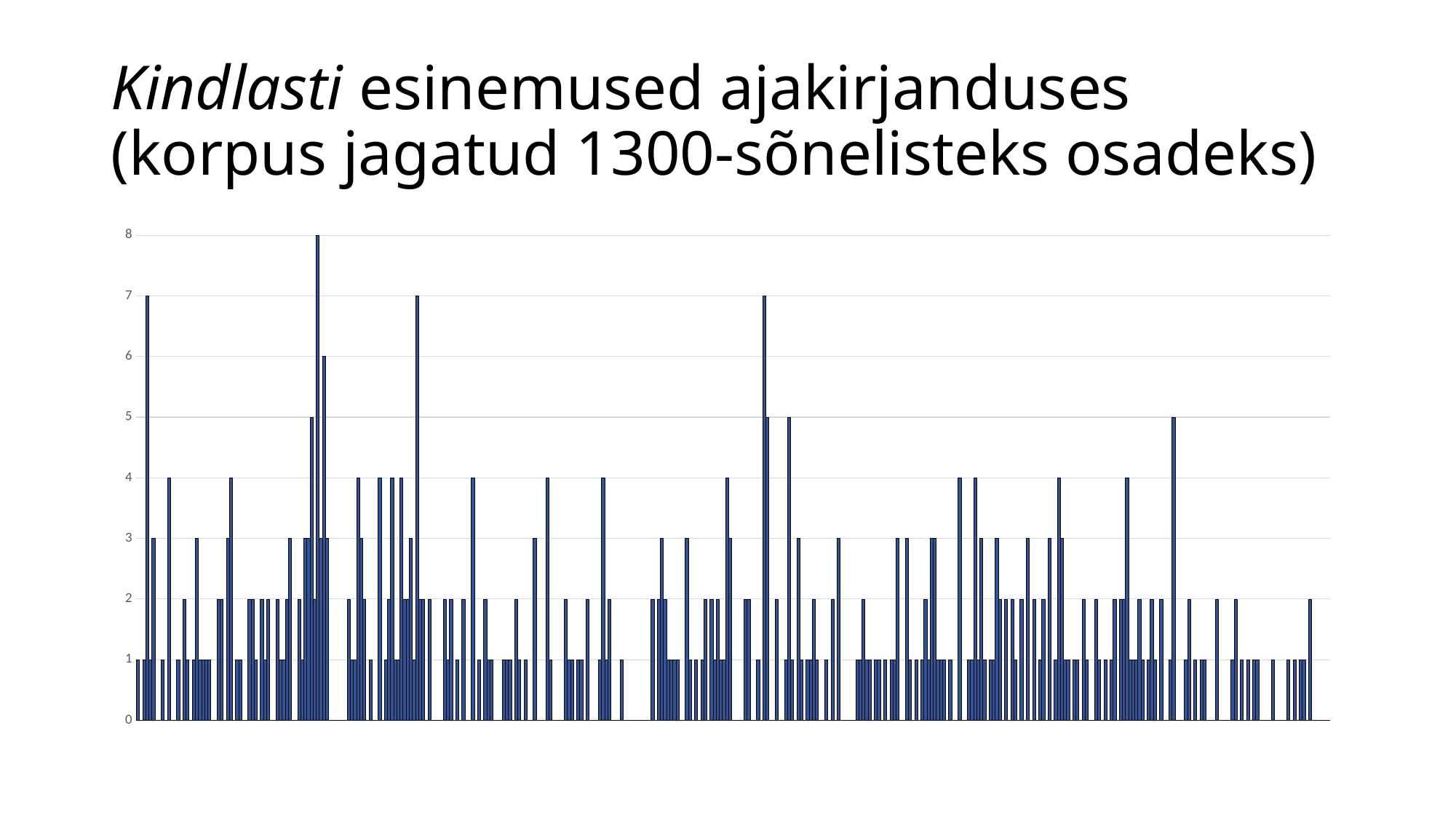
What is the highest value reached by any bar in the chart? 8 What is the highest tick value shown on the vertical axis? 8 What kind of chart is shown on the slide? bar chart Is the tallest bar in the chart greater or less than 6? greater What is the title of the chart on the slide? Kindlasti esinemused ajakirjanduses (korpus jagatud 1300-sõnelisteks osadeks) What is the lowest tick value shown on the vertical axis? 0